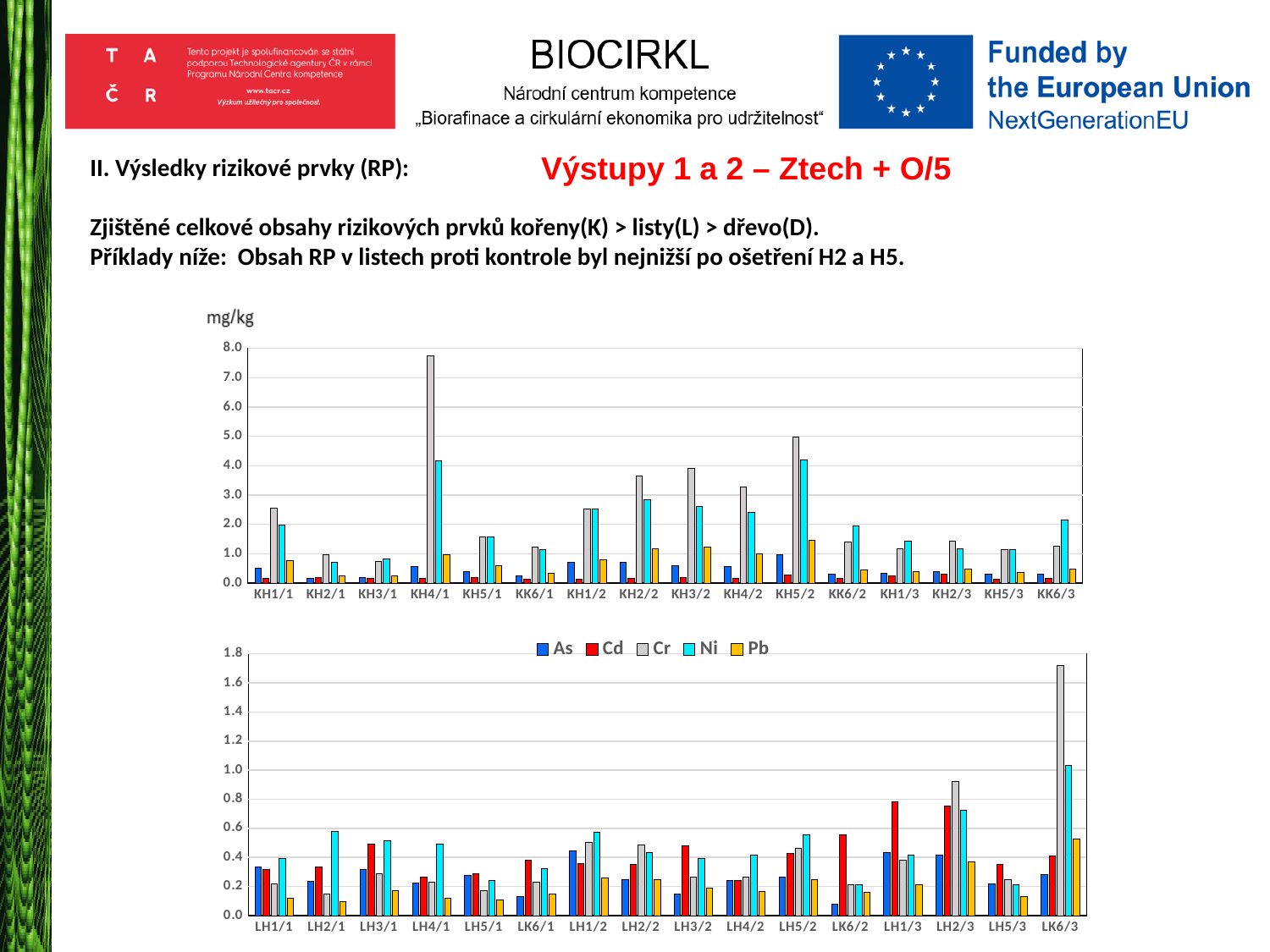
In the top chart, is the Cr value for KH4/1 greater or less than 7.0? greater How many categories are shown on the x axis of the bottom chart? 16 What unit is shown on the y axis of the top chart? mg/kg How many categories are shown on the x axis of the top chart? 16 In the top chart, which is larger: the Cr value for KH4/1 or the Cr value for KH5/2? KH4/1 In the top chart, which category has the highest Cr value? KH4/1 What kind of chart is the top chart on the slide? bar chart In the bottom chart, is the Cr value for LK6/3 greater or less than 1.6? greater In the bottom chart, is the Cd value for LH1/3 greater or less than 0.6? greater How many series does the legend list? 5 In the bottom chart, which category has the highest Cr value? LK6/3